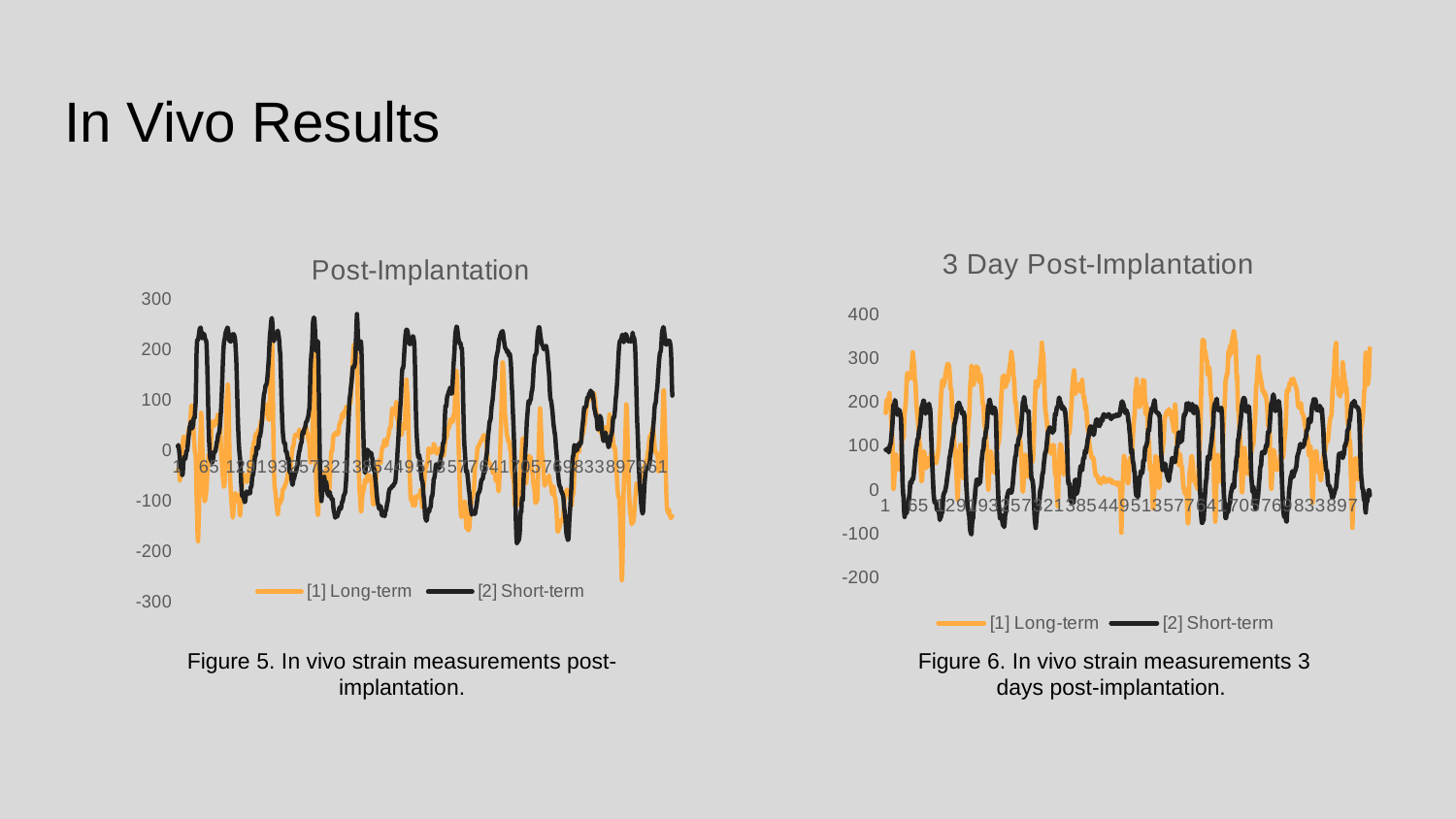
In the right chart (3 Day Post-Implantation), are the peaks of the [2] Short-term series greater or less than 300? less What kind of chart is the left chart titled "Post-Implantation"? line chart In the left chart (Post-Implantation), how many series does the legend list? 2 In the left chart (Post-Implantation), are the peaks of the [2] Short-term series greater or less than 200? greater In the right chart (3 Day Post-Implantation), how many series does the legend list? 2 What kind of chart is the right chart titled "3 Day Post-Implantation"? line chart In the right chart (3 Day Post-Implantation), which series reaches higher peak values, [1] Long-term or [2] Short-term? [1] Long-term In the right chart (3 Day Post-Implantation), are the highest peaks of the [1] Long-term series greater or less than 300? greater In the left chart (Post-Implantation), which series is drawn in orange? [1] Long-term In the right chart (3 Day Post-Implantation), which series is drawn in black? [2] Short-term In the left chart (Post-Implantation), which series reaches higher peak values, [1] Long-term or [2] Short-term? [2] Short-term